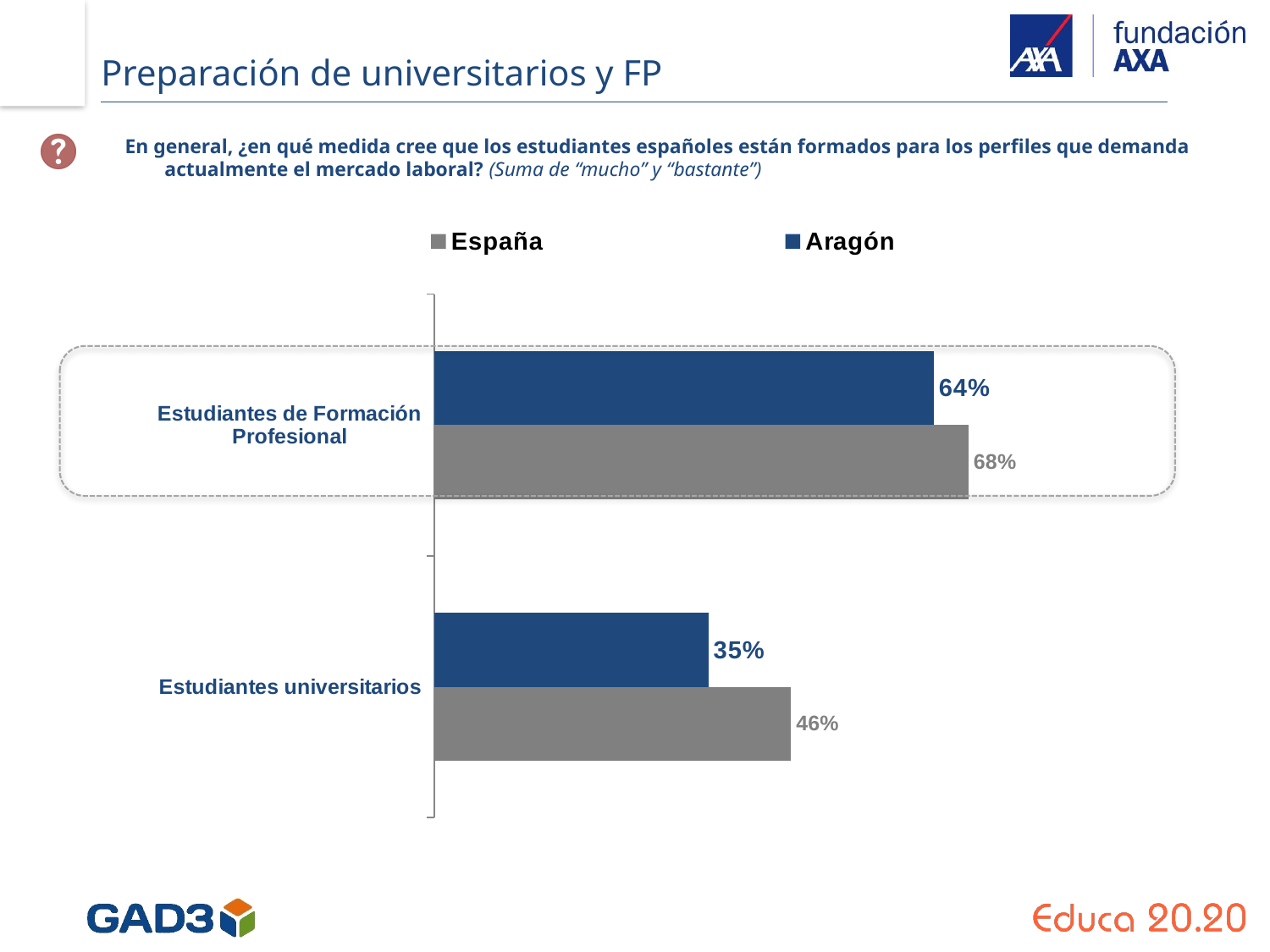
Which category has the highest value for España? Estudiantes de Formación Profesional What is the value for Aragón for Estudiantes de Formación Profesional? 64% Which category has the lowest value for Aragón? Estudiantes universitarios What is the value for Aragón for Estudiantes universitarios? 35% What is the value for España for Estudiantes de Formación Profesional? 68% For Estudiantes universitarios, which is larger: the España value or the Aragón value? España What is the difference between the España and Aragón values for Estudiantes universitarios? 11 percentage points How many categories are shown on the chart? 2 What is the difference between the España and Aragón values for Estudiantes de Formación Profesional? 4 percentage points What is the value for España for Estudiantes universitarios? 46% What kind of chart is shown on the slide? Bar chart How many series does the legend list? 2